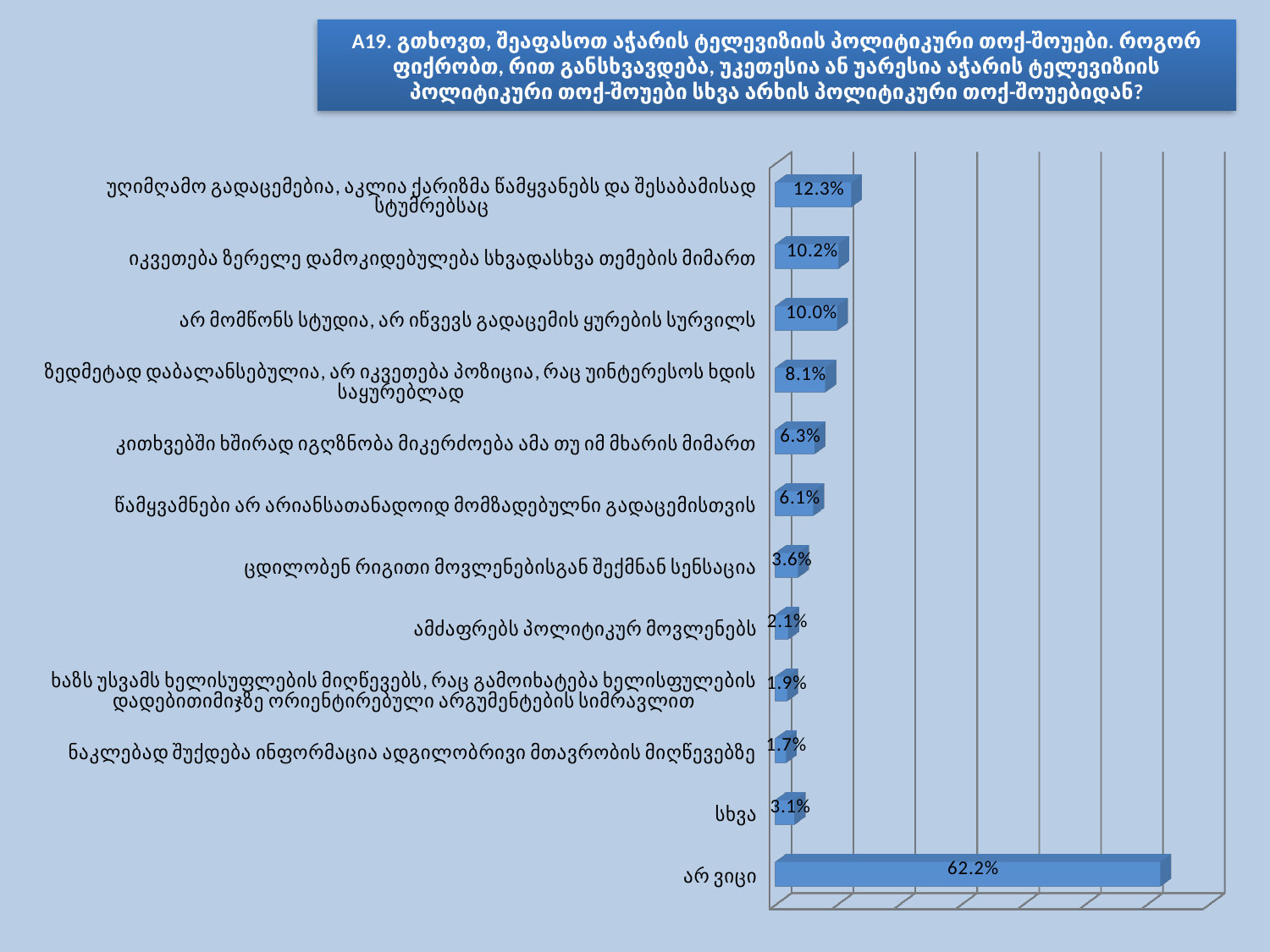
What value is shown for the category "სხვა"? 3.1% How many categories are plotted in the chart? 12 What value is shown for "ცდილობენ რიგითი მოვლენებისგან შექმნან სენსაცია"? 3.6% Which category has the highest value? არ ვიცი What value is shown for "ზედმეტად დაბალანსებულია, არ იკვეთება პოზიცია, რაც უინტერესოს ხდის საყურებლად"? 8.1% What kind of chart is shown on the slide? Bar chart What is the difference between the value for "არ ვიცი" and the value for "უღიმღამო გადაცემებია, აკლია ქარიზმა წამყვანებს და შესაბამისად სტუმრებსაც"? 49.9% What value is shown for the category "არ ვიცი"? 62.2% What is the difference between the values for "იკვეთება ზერელე დამოკიდებულება სხვადასხვა თემების მიმართ" and "არ მომწონს სტუდია, არ იწვევს გადაცემის ყურების სურვილს"? 0.2% Which is larger: the value for "კითხვებში ხშირად იგრძნობა მიკერძოება ამა თუ იმ მხარის მიმართ" or the value for "სხვა"? კითხვებში ხშირად იგრძნობა მიკერძოება ამა თუ იმ მხარის მიმართ What value is shown for "ამძაფრებს პოლიტიკურ მოვლენებს"? 2.1% Which category has the lowest value? ნაკლებად შუქდება ინფორმაცია ადგილობრივი მთავრობის მიღწევებზე